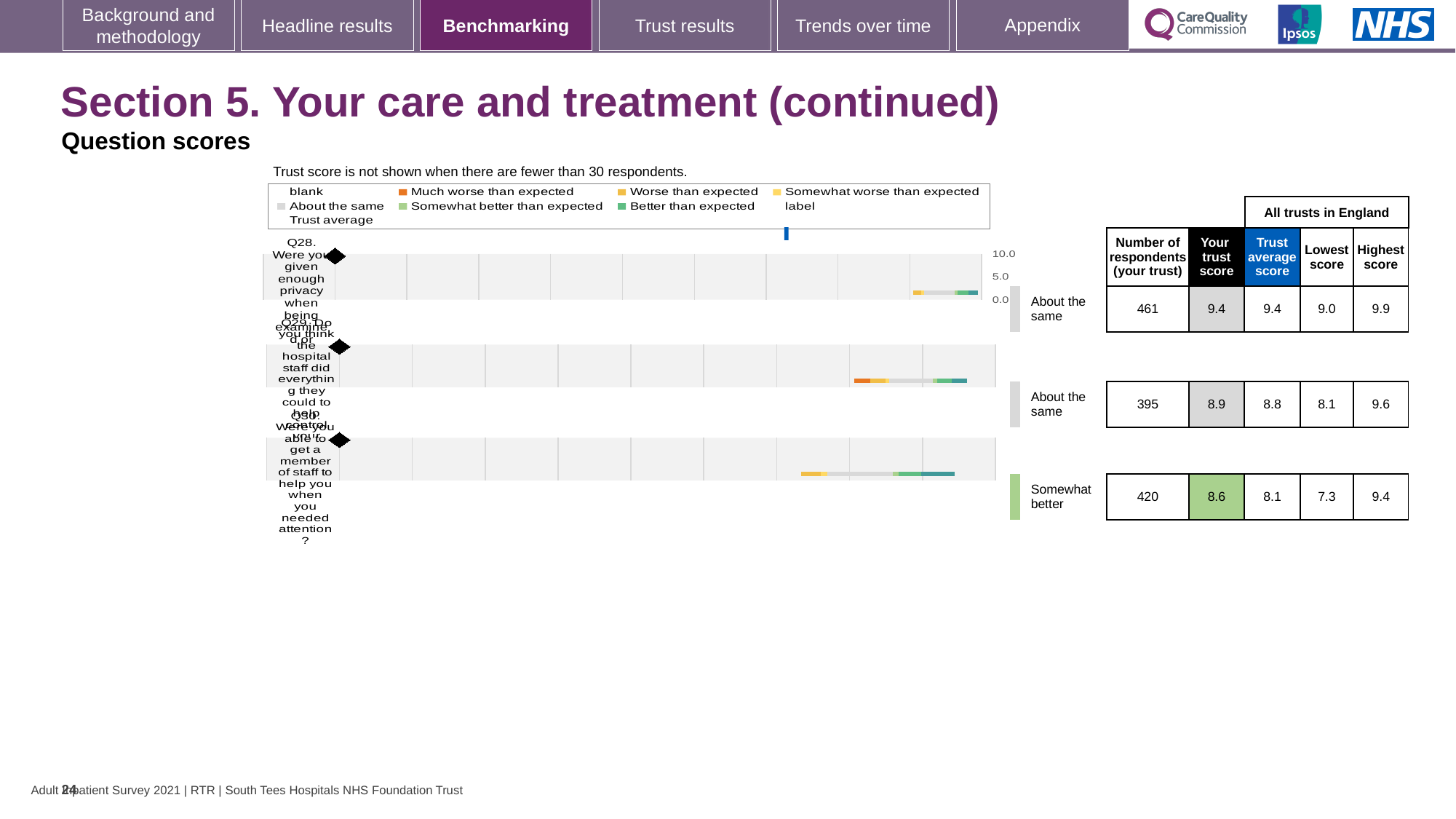
Which of the three questions has the lowest 'Your trust score'? Q30 How many questions (Q28, Q29, Q30) have a score chart on this slide? 3 What is 'Your trust score' for Q30 (Were you able to get a member of staff to help you when you needed attention)? 8.6 What kind of chart is used to show the question scores for Q28, Q29 and Q30? Bar chart Is the trust score for Q30 greater or less than 5.0 on the chart axis? greater Which of the three questions has the highest 'Your trust score'? Q28 What is the difference between 'Your trust score' for Q28 and for Q30? 0.8 How many respondents answered Q29 for your trust? 395 What is 'Your trust score' for Q28 (Were you given enough privacy when being examined or treated)? 9.4 What benchmark category is shown next to the Q30 chart? Somewhat better What is the trust average score across all trusts in England for Q30? 8.1 For Q29, which is larger: 'Your trust score' or the 'Trust average score'? Your trust score